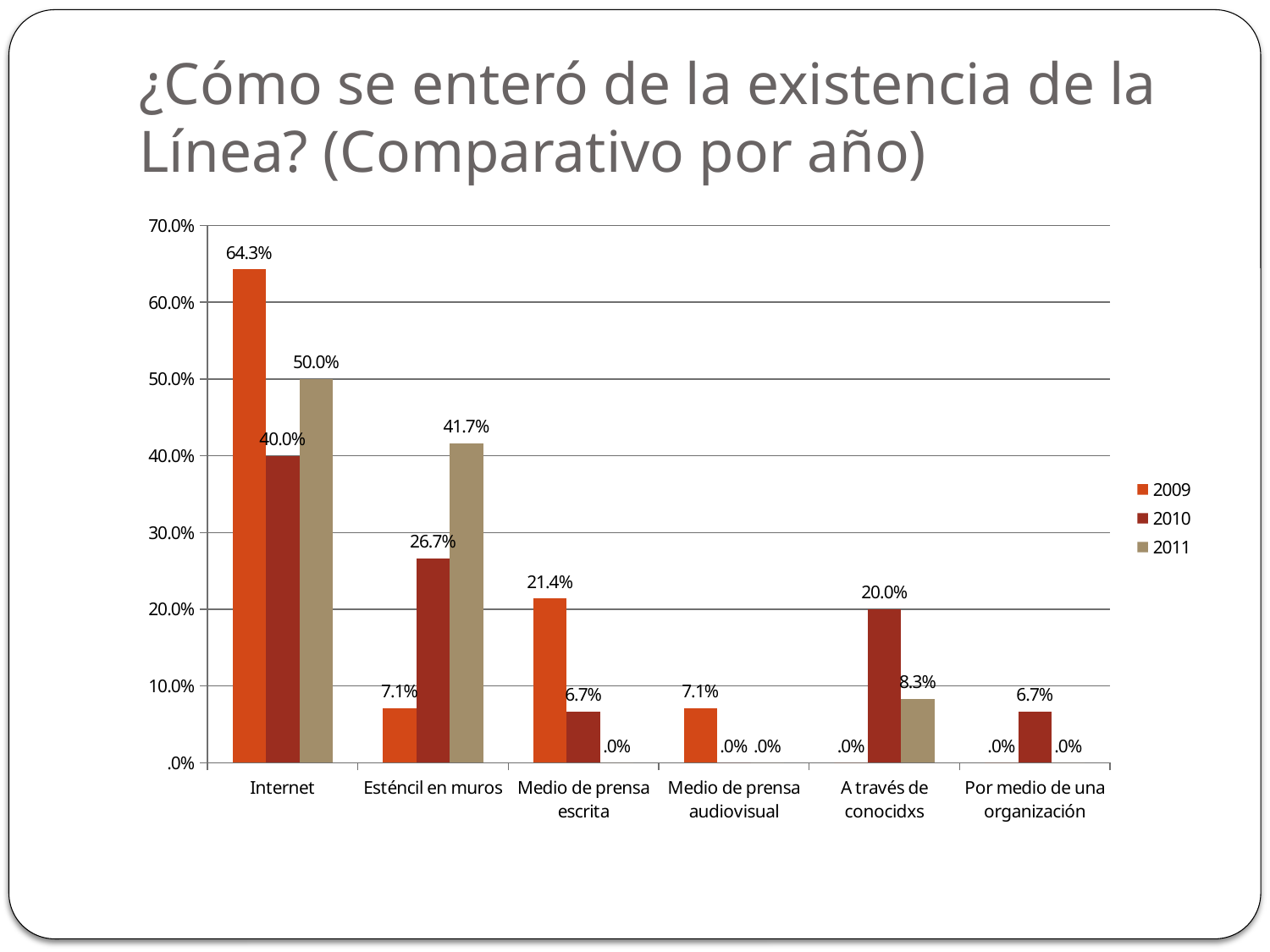
Which category has the highest value in the 2010 series? Internet Which is larger for A través de conocidxs: the 2010 value or the 2011 value? 2010 What is the value for Medio de prensa escrita in the 2009 series? 21.4% What is the value for Internet in the 2009 series? 64.3% What is the value for A través de conocidxs in the 2010 series? 20.0% What is the value for Esténcil en muros in the 2011 series? 41.7% What is the difference between the 2009 and 2011 values for Internet? 14.3% What kind of chart is shown on the slide? Bar chart How many categories are shown on the x axis? 6 Which category has the highest value in the 2011 series? Internet How many series does the legend list? 3 What is the difference between the 2011 and 2010 values for Esténcil en muros? 15.0%